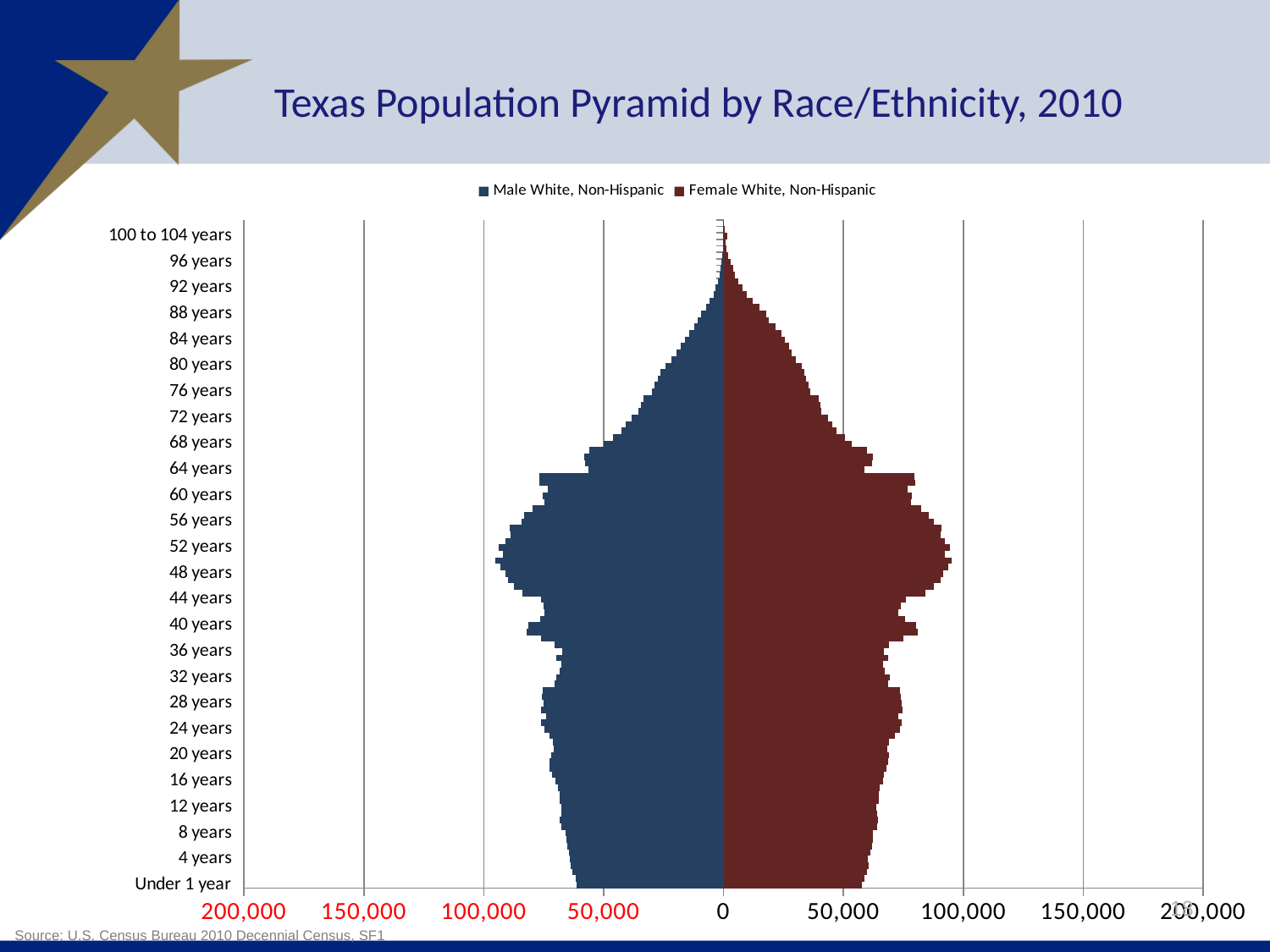
Is the value for Female White, Non-Hispanic at 52 years greater or less than 100,000? less Is the value for Female White, Non-Hispanic at 52 years greater or less than 50,000? greater Is the value for Male White, Non-Hispanic at 80 years greater or less than 50,000? less Which series is shown in dark red? Female White, Non-Hispanic Moving from 60 years up to 100 to 104 years, do the bars get longer or shorter? shorter What is the title of the chart? Texas Population Pyramid by Race/Ethnicity, 2010 What kind of chart is shown on the slide? Bar chart (population pyramid) Which is larger for Male White, Non-Hispanic: the value at 48 years or the value at 20 years? 48 years Which is larger for Female White, Non-Hispanic: the value at 52 years or the value at 80 years? 52 years How many series does the legend list? 2